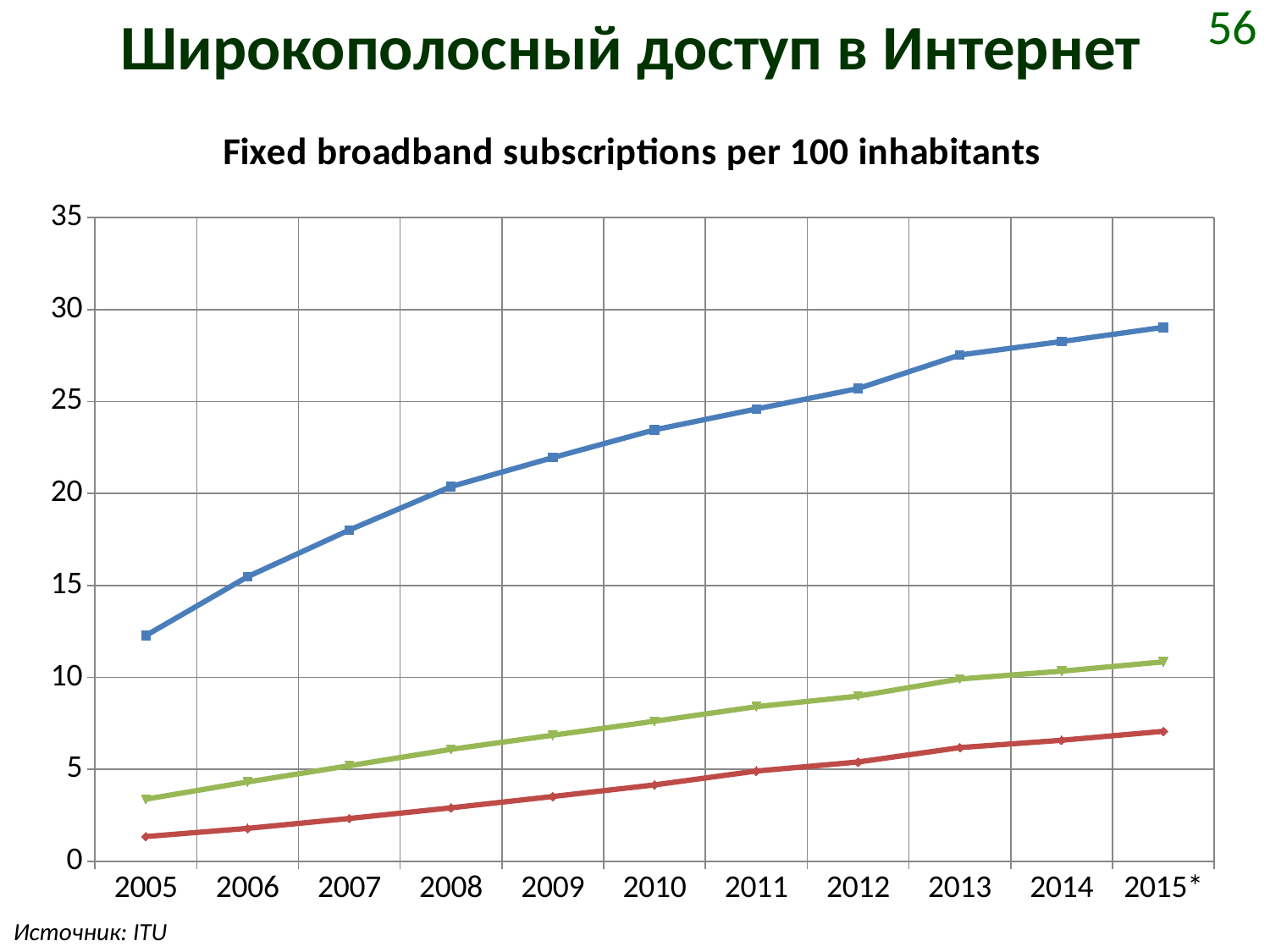
Is the value of the red line in 2005 greater or less than 5? less Which line has the highest values throughout the chart? the blue line Is the value of the green line in 2015* greater or less than 10? greater Which line has the lowest values throughout the chart? the red line What is the title of the chart? Fixed broadband subscriptions per 100 inhabitants Do the values of the blue line rise or fall from 2005 to 2015*? rise What kind of chart is shown on the slide? line chart Is the value of the blue line in 2015* greater or less than 30? less How many years are shown on the x axis of the chart? 11 In 2010, which line has the larger value, the blue line or the green line? the blue line How many lines are plotted on the chart? 3